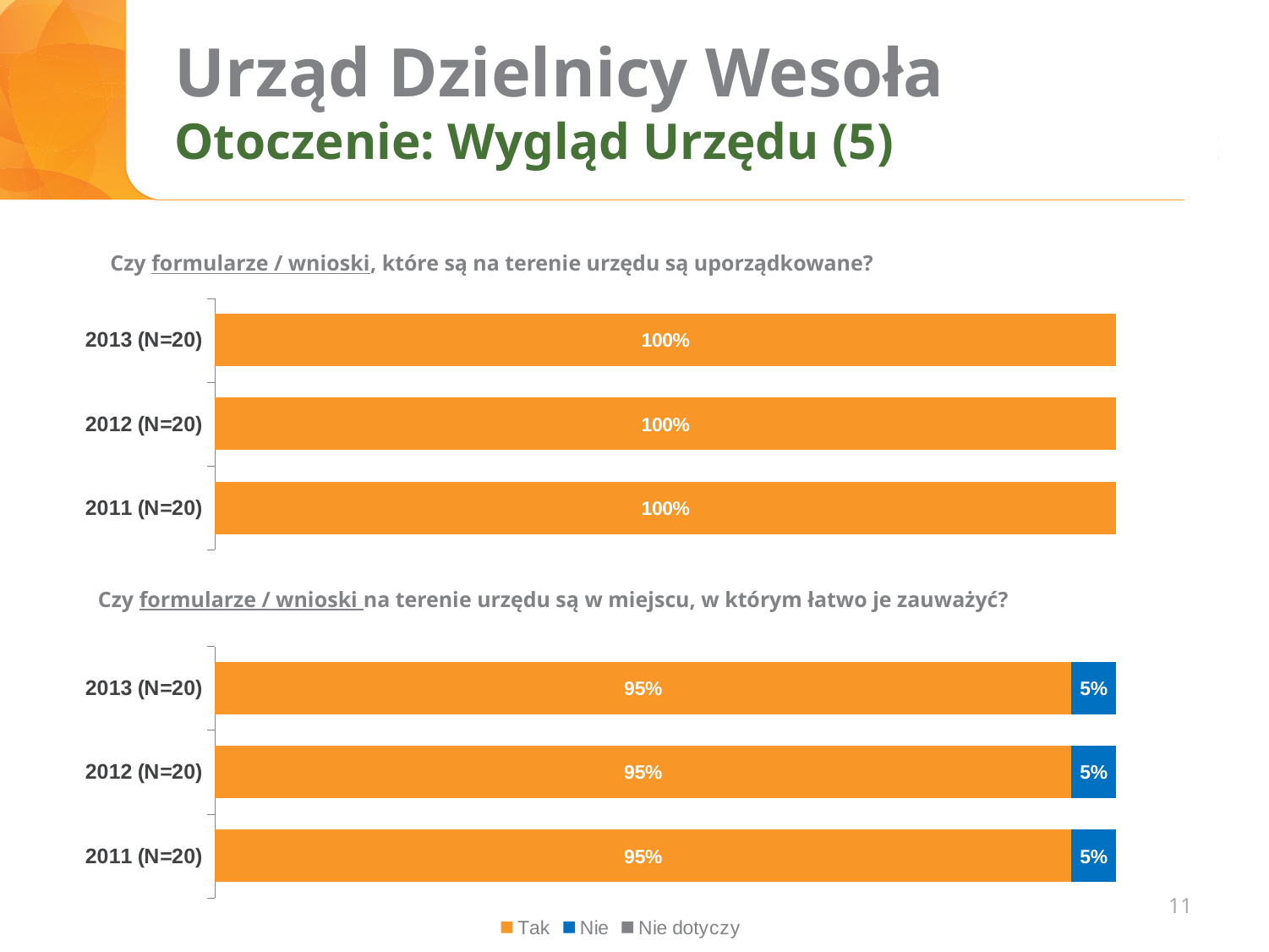
In the bottom chart ("Czy formularze / wnioski na terenie urzędu są w miejscu, w którym łatwo je zauważyć?"), what is the value for "Nie" in 2013 (N=20)? 5% In the bottom chart ("Czy formularze / wnioski na terenie urzędu są w miejscu, w którym łatwo je zauważyć?"), what is the difference between the "Tak" and "Nie" values for 2011 (N=20)? 90% What kind of chart is the bottom chart ("Czy formularze / wnioski na terenie urzędu są w miejscu, w którym łatwo je zauważyć?")? Stacked bar chart In the top chart ("Czy formularze / wnioski, które są na terenie urzędu są uporządkowane?"), what is the value for "Tak" in 2011 (N=20)? 100% In the bottom chart ("Czy formularze / wnioski na terenie urzędu są w miejscu, w którym łatwo je zauważyć?"), does the "Tak" value change between 2011 (N=20) and 2013 (N=20)? No, it stays at 95% In the top chart ("Czy formularze / wnioski, które są na terenie urzędu są uporządkowane?"), what is the value for "Tak" in 2013 (N=20)? 100% In the bottom chart ("Czy formularze / wnioski na terenie urzędu są w miejscu, w którym łatwo je zauważyć?"), what is the total of the stacked bar for 2012 (N=20)? 100% Which series is shown in orange in the legend at the bottom of the slide? Tak How many year categories are shown in the top chart ("Czy formularze / wnioski, które są na terenie urzędu są uporządkowane?")? 3 In the bottom chart ("Czy formularze / wnioski na terenie urzędu są w miejscu, w którym łatwo je zauważyć?"), what is the value for "Tak" in 2012 (N=20)? 95% How many series does the legend at the bottom of the slide list? 3 In the bottom chart ("Czy formularze / wnioski na terenie urzędu są w miejscu, w którym łatwo je zauważyć?"), which is larger for 2013 (N=20): "Tak" or "Nie"? Tak